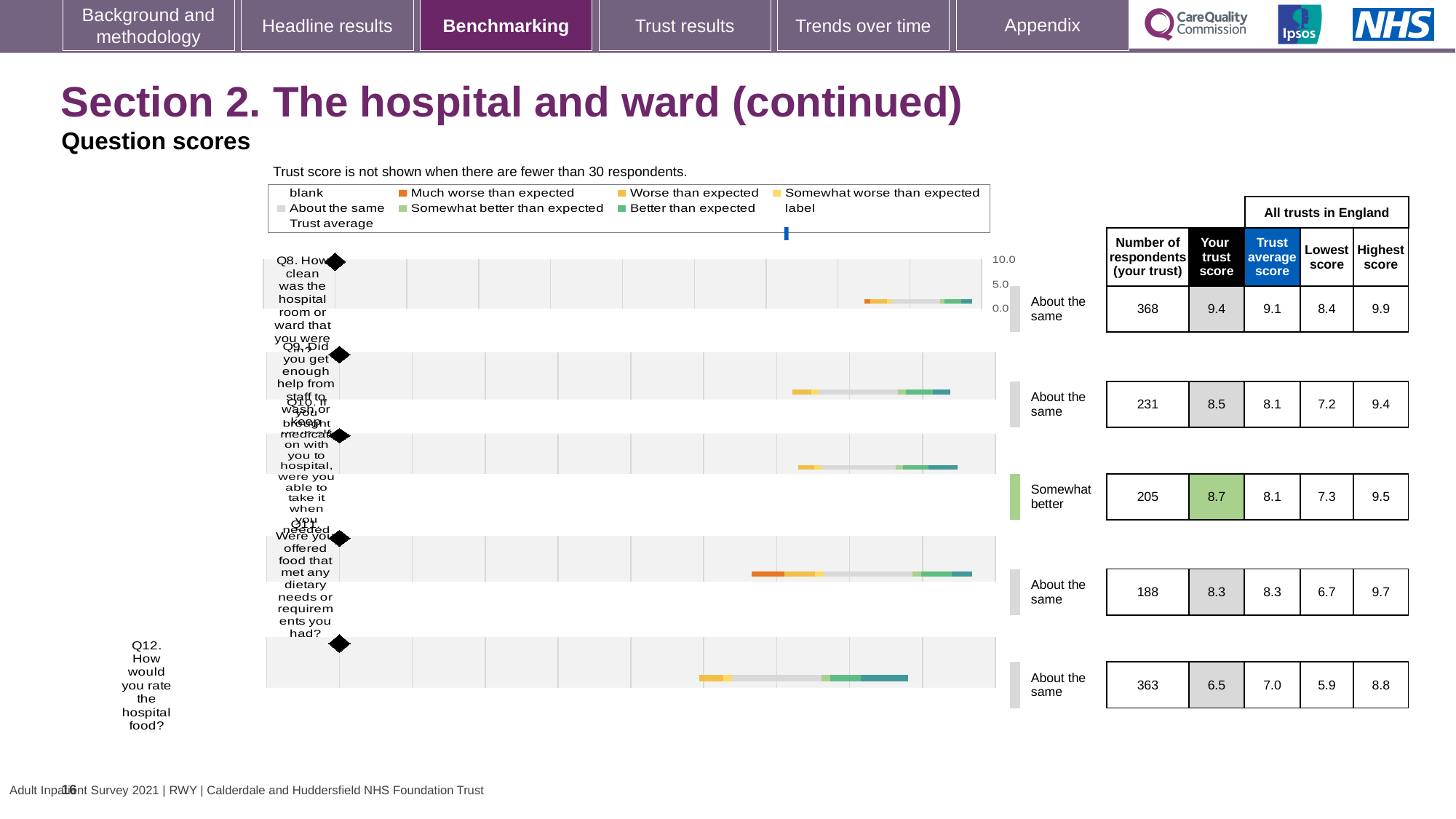
What is the difference between the trust score and the trust average score for Q8? 0.3 How many questions (Q8 to Q12) are plotted in the question scores chart? 5 What is the lowest score across all trusts in England for Q11 (food that met dietary needs)? 6.7 Which question has the highest 'Your trust score' in the table? Q8 For Q10, which is larger: the trust score or the trust average score? trust score What kind of chart is used to show the question scores on this slide? bar chart Which question is rated 'Somewhat better' rather than 'About the same'? Q10 Which question has the lowest 'Your trust score' in the table? Q12 What is the trust score for Q8 (how clean was the hospital room or ward)? 9.4 What is the difference between the highest and lowest scores across all trusts for Q12? 2.9 What is the highest score across all trusts in England for Q9? 9.4 How many respondents answered Q12 (how would you rate the hospital food)? 363